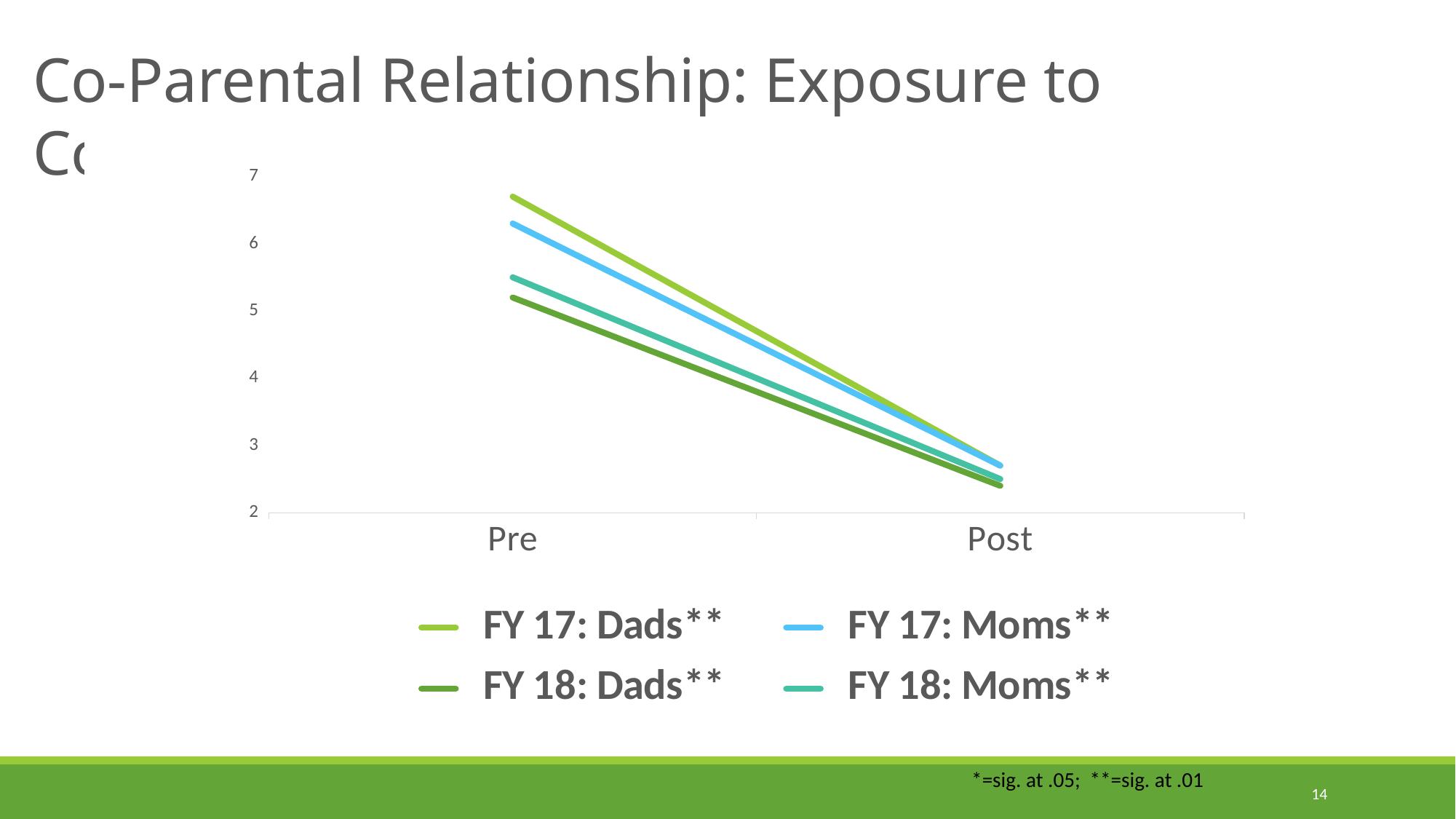
Is the value for FY 17: Dads** at Pre greater or less than 6? greater What kind of chart is shown on the slide? line chart Is the value for FY 17: Moms** at Post greater or less than 3? less Which series has the lowest value at Pre? FY 18: Dads** Which series has the highest value at Pre? FY 17: Dads** Do the values for FY 18: Moms** rise or fall from Pre to Post? fall How many series does the legend list? 4 At Pre, which is larger: FY 17: Moms** or FY 18: Moms**? FY 17: Moms** Do the values for FY 17: Dads** rise or fall from Pre to Post? fall Is the value for FY 18: Dads** at Pre greater or less than 5? greater What are the two category labels on the x axis? Pre and Post How many categories are shown on the x axis? 2